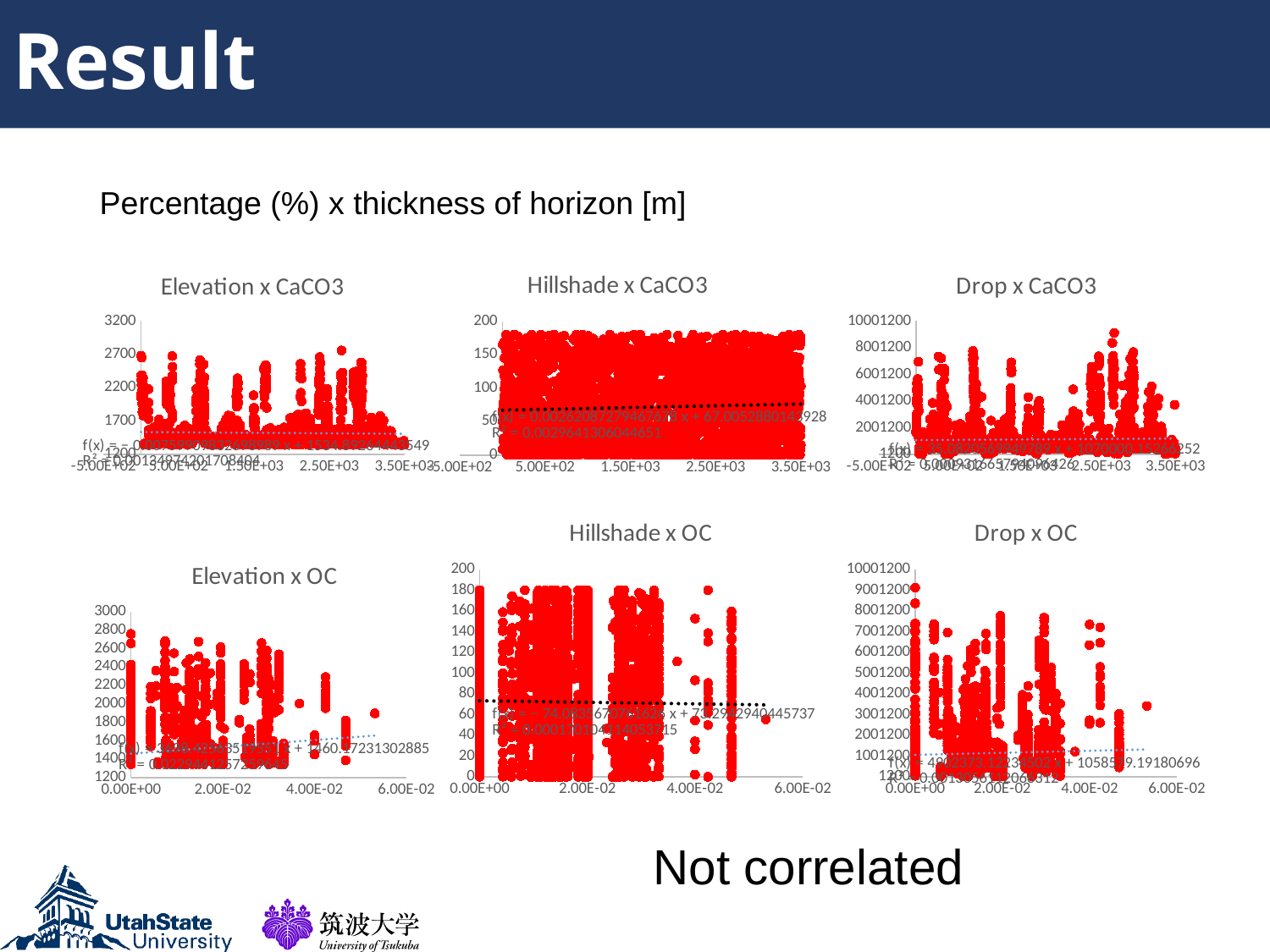
What kind of chart is 'Drop x OC'? scatter chart In the 'Hillshade x OC' chart, is the lowest plotted point greater or less than 20 on the y axis? less In the 'Elevation x CaCO3' chart, is the highest plotted point greater or less than 2200 on the y axis? greater How many charts are shown on the slide? 6 In the 'Drop x OC' chart, is the highest plotted point greater or less than 8001200 on the y axis? greater What kind of chart is 'Hillshade x OC'? scatter chart What is the title of the chart in the top-right position of the slide? Drop x CaCO3 What kind of chart is 'Elevation x CaCO3'? scatter chart